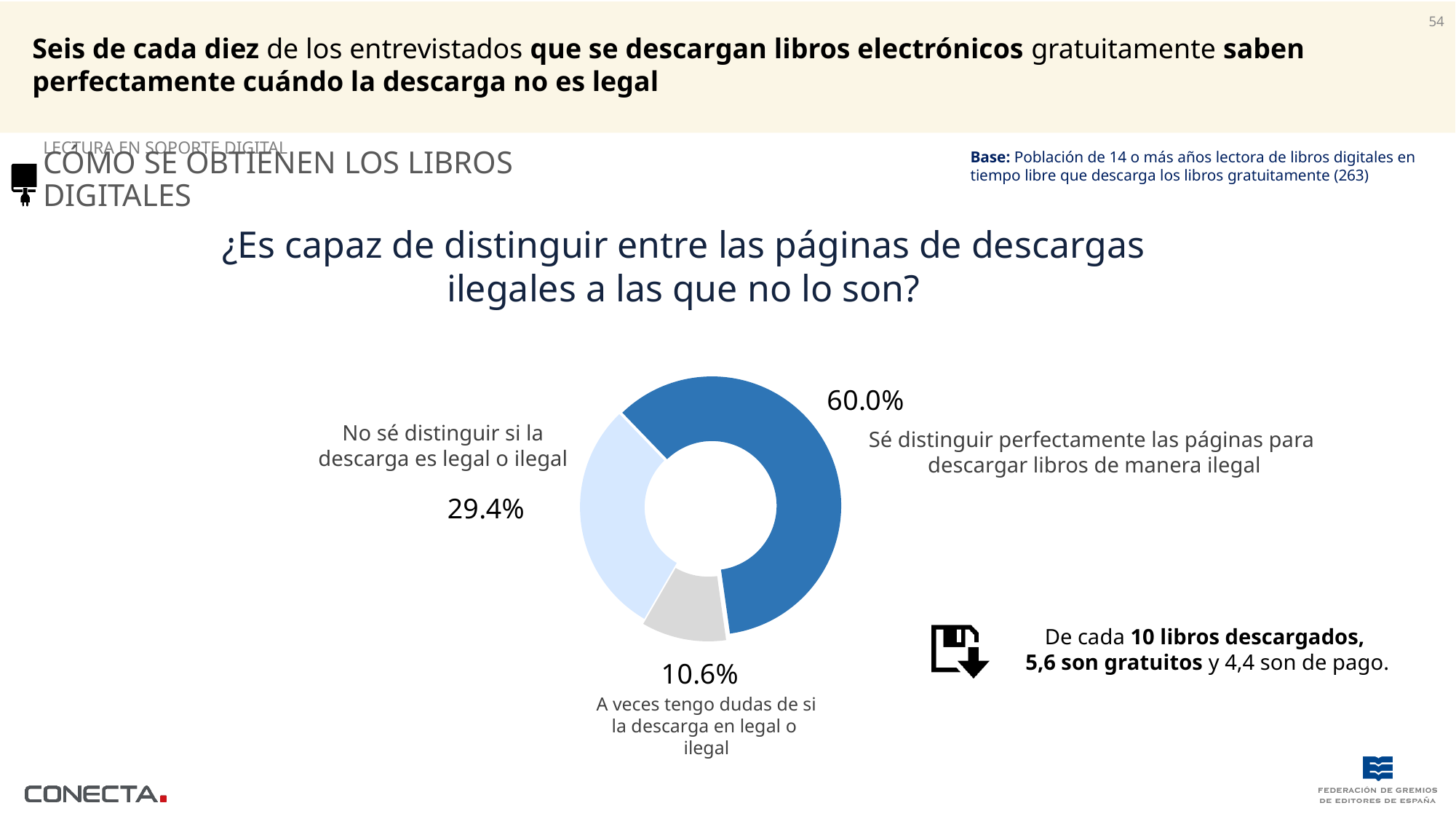
Which is larger: the share for 'No sé distinguir si la descarga es legal o ilegal' or for 'A veces tengo dudas'? No sé distinguir si la descarga es legal o ilegal What percentage of respondents say they do not know how to distinguish whether a download is legal or illegal? 29.4% What percentage of respondents say they sometimes have doubts about whether a download is legal or illegal? 10.6% What is the combined share of the two categories other than 'Sé distinguir perfectamente'? 40.0% How many response categories are shown in the chart? 3 What is the difference in percentage points between 'Sé distinguir perfectamente' and 'No sé distinguir'? 30.6 What percentage of respondents say they can perfectly distinguish pages for downloading books illegally? 60.0% What type of chart is shown on the slide? Doughnut (pie) chart What is the difference in percentage points between 'No sé distinguir' and 'A veces tengo dudas'? 18.8 Which response has the smallest share of the chart? A veces tengo dudas de si la descarga en legal o ilegal Which response has the largest share of the chart? Sé distinguir perfectamente las páginas para descargar libros de manera ilegal What question does the chart title ask? ¿Es capaz de distinguir entre las páginas de descargas ilegales a las que no lo son?